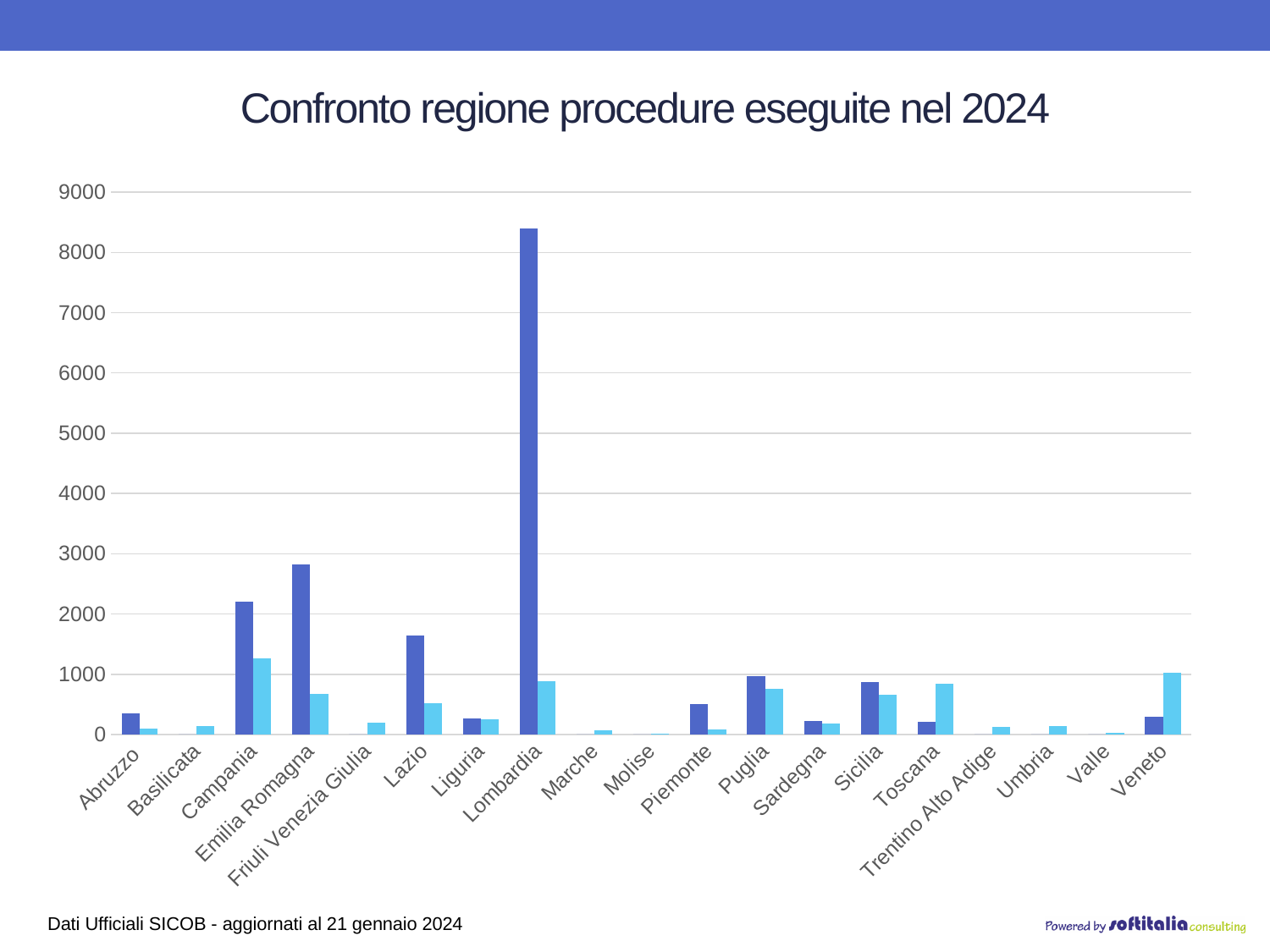
Which is larger for Toscana, the dark blue bar or the light blue bar? the light blue bar How many regions are shown on the x axis of the chart? 19 Which region has the highest dark blue bar? Lombardia Is the dark blue value for Emilia Romagna greater or less than 3000? less Which is larger, the dark blue bar for Emilia Romagna or the dark blue bar for Campania? Emilia Romagna What is the title of the chart? Confronto regione procedure eseguite nel 2024 Is the dark blue value for Lombardia greater or less than 8000? greater Which is larger, the dark blue bar for Lazio or the dark blue bar for Puglia? Lazio Which region has the highest light blue bar? Campania What kind of chart is shown on the slide? bar chart Is the dark blue value for Campania greater or less than 2000? greater